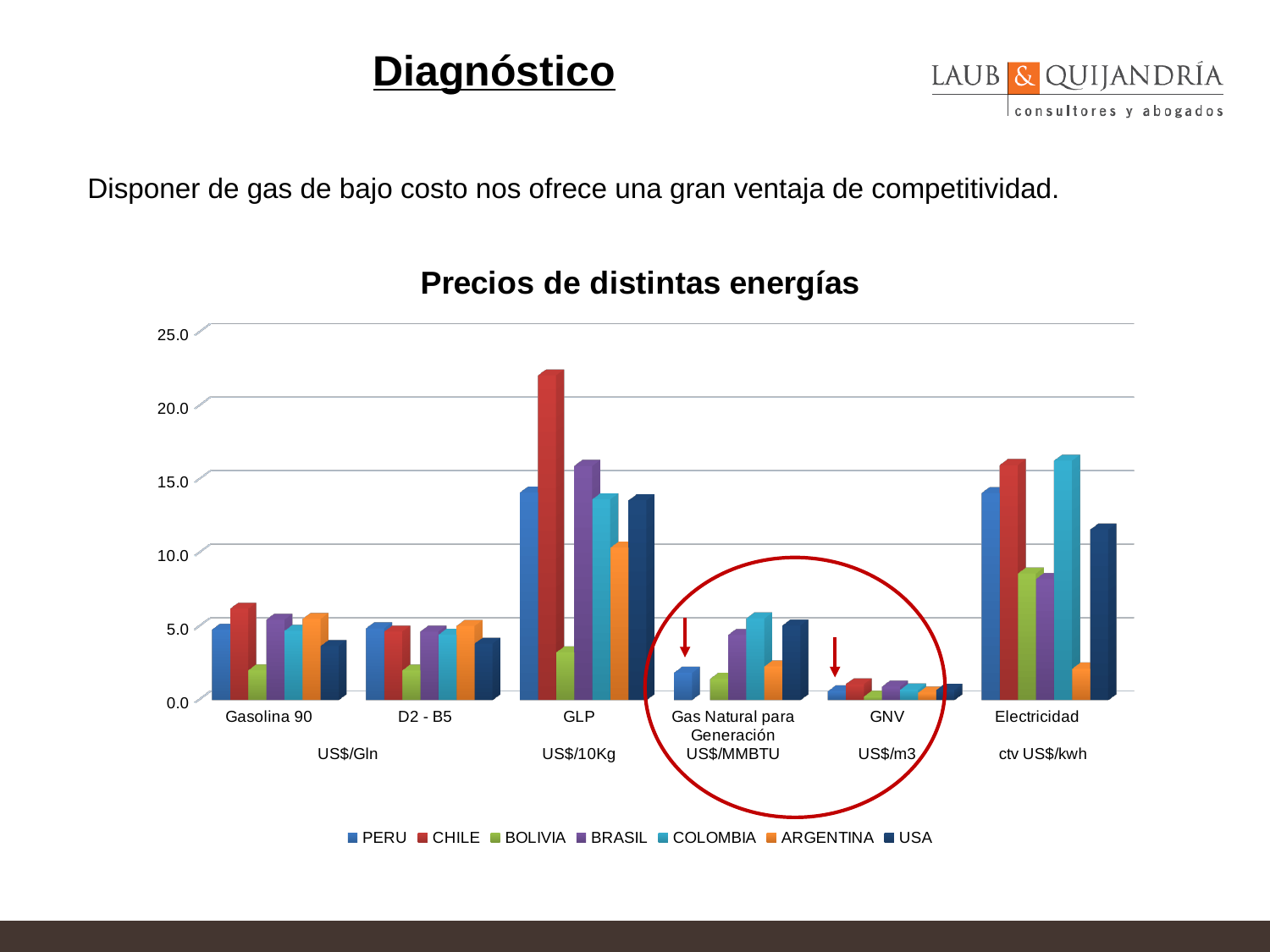
Is the Electricidad value for PERU greater or less than 10.0? greater Which country has the lowest Electricidad price in the chart? ARGENTINA Is the Gasolina 90 value for BOLIVIA greater or less than 5.0? less Is the GLP value for CHILE greater or less than 20.0? greater How many energy categories are shown along the x axis of the chart? 6 Which country has the highest GLP price in the chart? CHILE Which country has the lowest Gasolina 90 price? BOLIVIA What is the title of the chart? Precios de distintas energías How many countries does the chart legend list? 7 What kind of chart is shown on the slide? Bar chart For GLP, which is larger: the value for CHILE or the value for BRASIL? CHILE